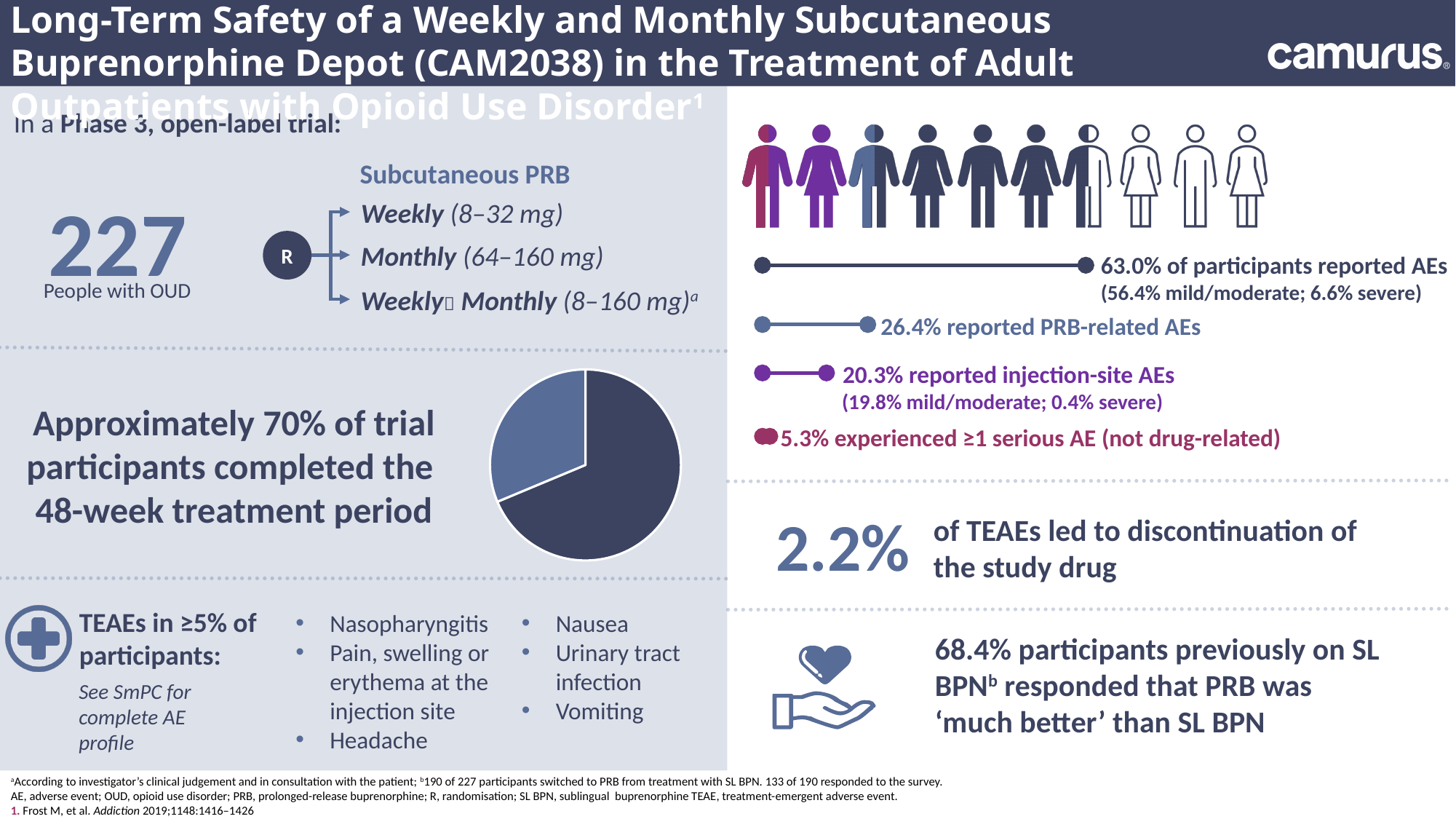
In the pie chart, which slice is larger: the dark navy slice or the lighter blue-grey slice? The dark navy slice What two colours are used for the slices of the pie chart? Dark navy and blue-grey In the adverse-event bar graphic on the right of the slide, which category has the highest percentage? Participants reported AEs (63.0%) In the adverse-event bar graphic on the right of the slide, which category has the lowest percentage? Experienced ≥1 serious AE (5.3%) What kind of chart is shown in the middle-left of the slide next to the text about the 48-week treatment period? Pie chart In the adverse-event bar graphic on the right of the slide, what is the difference in percentage points between participants who reported AEs and those who reported PRB-related AEs? 36.6 percentage points How many slices does the pie chart on the slide have? 2 In the adverse-event bar graphic on the right of the slide, what percentage experienced ≥1 serious AE? 5.3% In the adverse-event bar graphic on the right of the slide, what percentage reported injection-site AEs? 20.3% In the adverse-event bar graphic on the right of the slide, what percentage of participants reported AEs? 63.0% In the adverse-event bar graphic on the right of the slide, what is the difference in percentage points between injection-site AEs and serious AEs? 15.0 percentage points In the adverse-event bar graphic on the right of the slide, what percentage reported PRB-related AEs? 26.4%